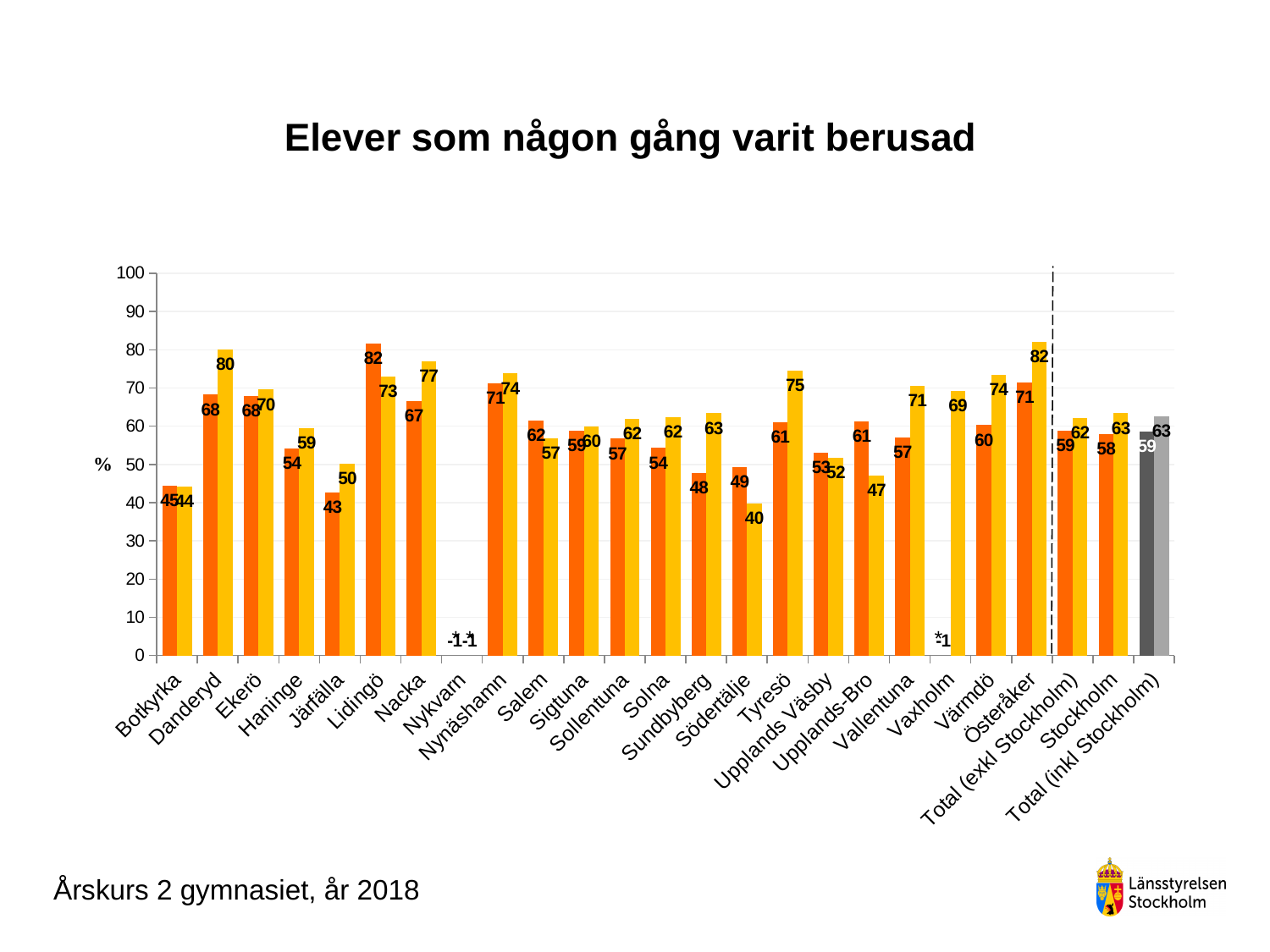
Is the yellow (right) bar for Nacka greater or less than 70? greater Which is larger for Upplands-Bro, the orange (left) bar or the yellow (right) bar? the orange (left) bar What is the difference between the yellow (right) bar and the orange (left) bar for Tyresö? 14 What kind of chart is shown on the slide? bar chart What is the title of the chart? Elever som någon gång varit berusad What is the value of the yellow (right) bar for Danderyd? 80 What is the value of the orange (left) bar for Total (inkl Stockholm)? 59 What is the value of the yellow (right) bar for Södertälje? 40 Which municipality has the lowest orange (left) bar among those with a plotted value? Järfälla How many categories are shown on the x axis? 25 Which municipality has the highest yellow (right) bar? Österåker What is the value of the orange (left) bar for Lidingö? 82